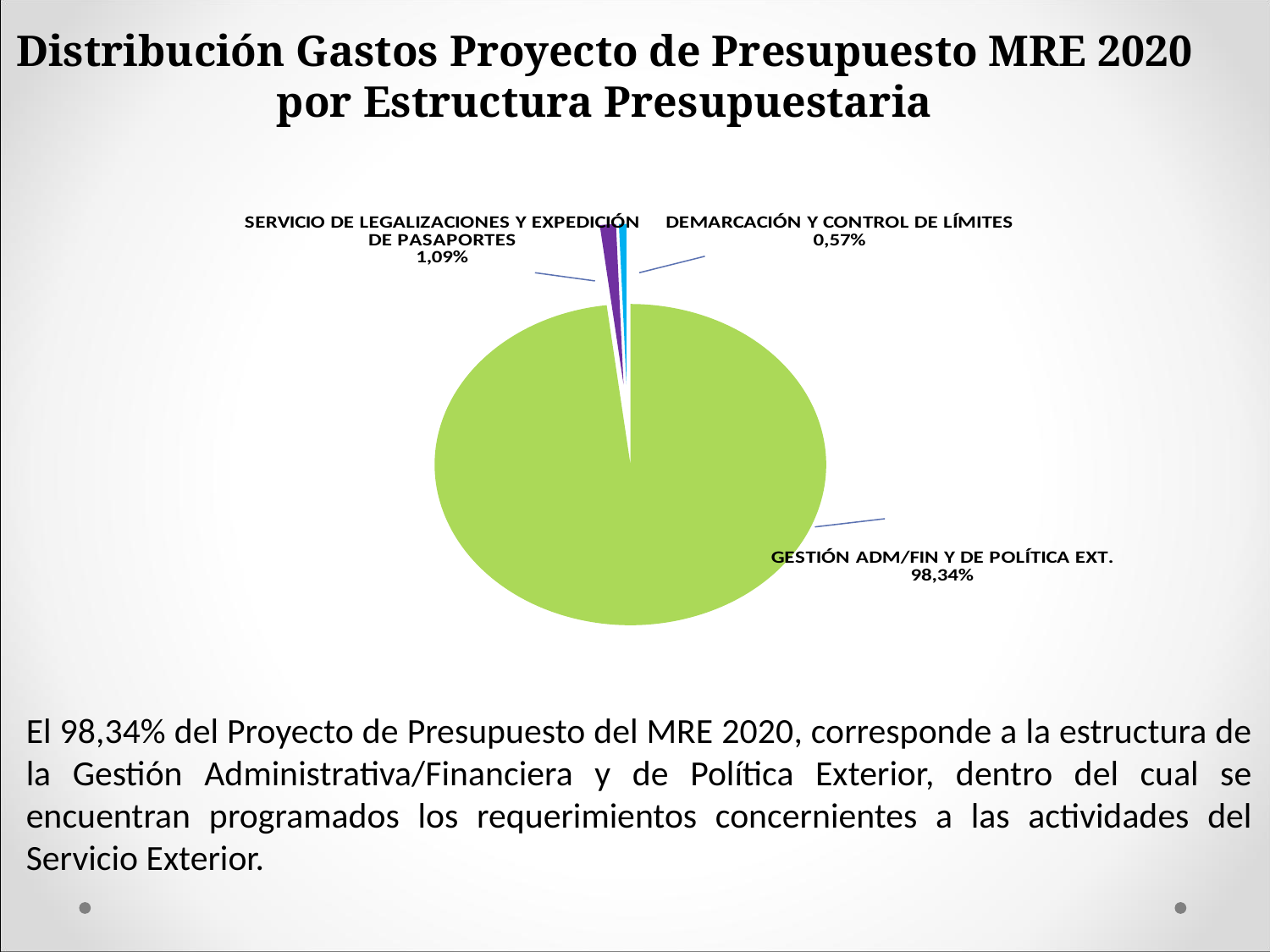
What share of the pie does GESTIÓN ADM/FIN Y DE POLÍTICA EXT. represent? 98,34% Which category has the largest slice of the pie? GESTIÓN ADM/FIN Y DE POLÍTICA EXT. Which is larger, the slice for SERVICIO DE LEGALIZACIONES Y EXPEDICIÓN DE PASAPORTES or the slice for DEMARCACIÓN Y CONTROL DE LÍMITES? SERVICIO DE LEGALIZACIONES Y EXPEDICIÓN DE PASAPORTES Which category has the smallest slice of the pie? DEMARCACIÓN Y CONTROL DE LÍMITES What is the difference in percentage points between SERVICIO DE LEGALIZACIONES Y EXPEDICIÓN DE PASAPORTES and DEMARCACIÓN Y CONTROL DE LÍMITES? 0,52% What type of chart is shown on the slide? Pie chart How many categories are shown in the pie chart? 3 What is the title of the slide containing the pie chart? Distribución Gastos Proyecto de Presupuesto MRE 2020 por Estructura Presupuestaria What share of the pie does DEMARCACIÓN Y CONTROL DE LÍMITES represent? 0,57% What share of the pie does SERVICIO DE LEGALIZACIONES Y EXPEDICIÓN DE PASAPORTES represent? 1,09% What colour is the slice for GESTIÓN ADM/FIN Y DE POLÍTICA EXT.? Green What is the difference in percentage points between GESTIÓN ADM/FIN Y DE POLÍTICA EXT. and SERVICIO DE LEGALIZACIONES Y EXPEDICIÓN DE PASAPORTES? 97,25%